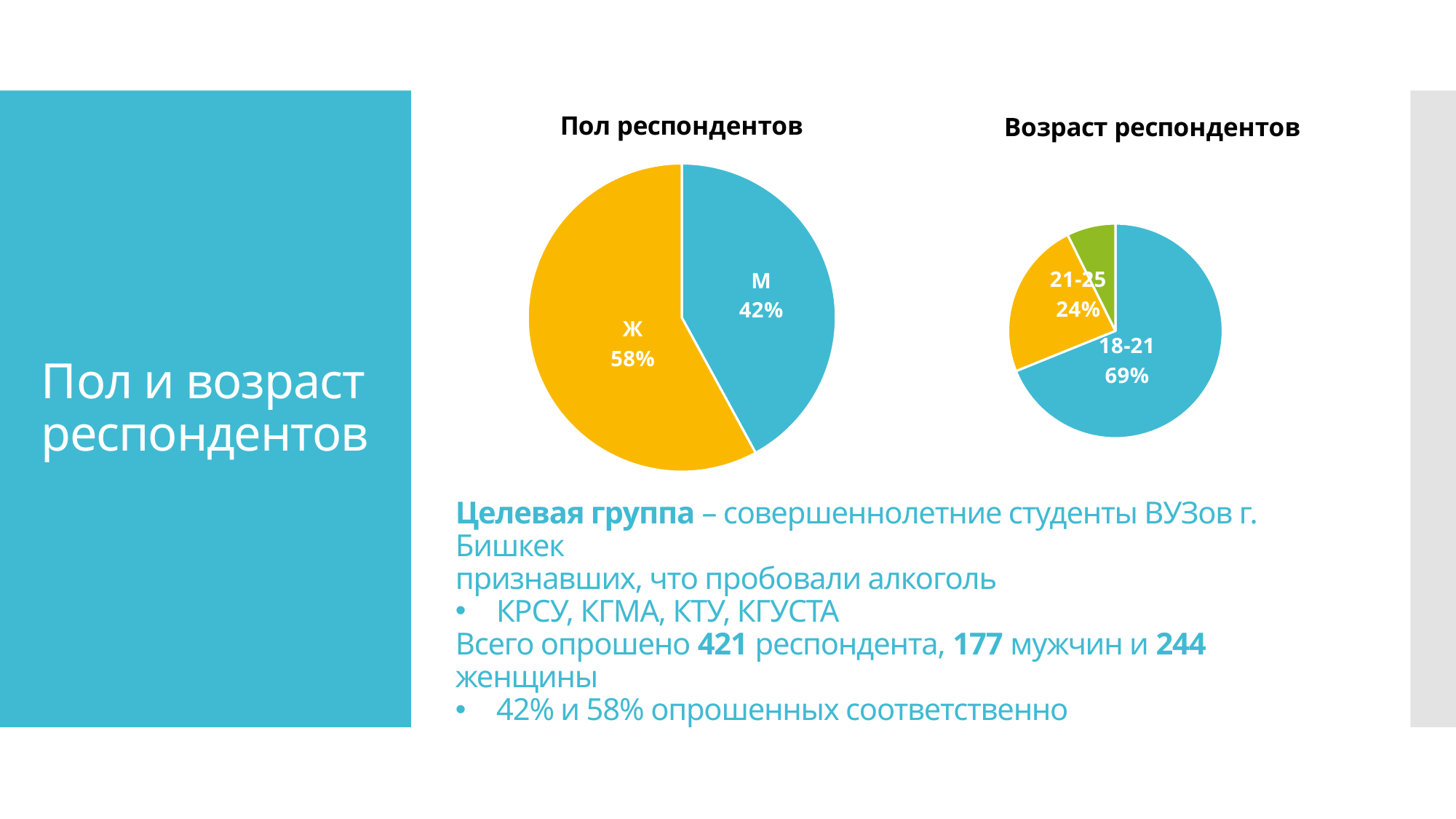
In the chart titled "Возраст респондентов", which labelled age group has the largest slice? 18-21 In the chart titled "Пол респондентов", which category has the larger slice? Ж In the chart titled "Пол респондентов", what share of respondents is labelled Ж? 58% In the chart titled "Возраст респондентов", what is the difference in percentage points between the 18-21 and 21-25 slices? 45 In the chart titled "Возраст респондентов", which slice is larger: 18-21 or 21-25? 18-21 In the chart titled "Возраст респондентов", what share of respondents is in the 18-21 group? 69% In the chart titled "Пол респондентов", what is the difference in percentage points between the Ж and М slices? 16 In the chart titled "Возраст респондентов", how many slices does the pie have? 3 In the chart titled "Возраст респондентов", what share of respondents is in the 21-25 group? 24% In the chart titled "Пол респондентов", what colour is the Ж slice? Yellow What kind of chart is the one titled "Пол респондентов"? Pie chart